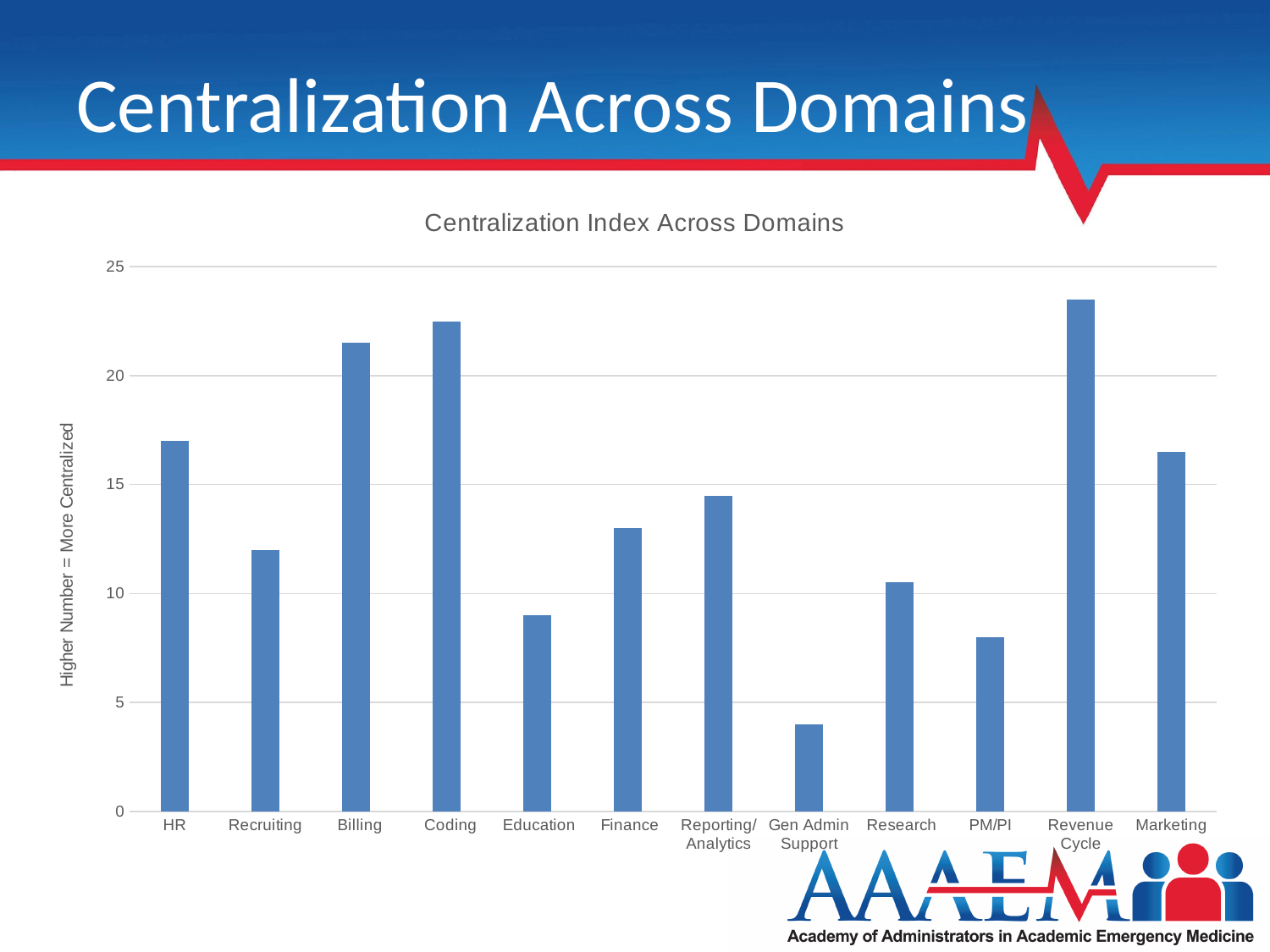
Is the value for Marketing greater or less than 15? greater Which has the higher centralization index, Recruiting or Finance? Finance Is the value for Gen Admin Support greater or less than 5? less Is the value for Education greater or less than 10? less What kind of chart is shown on the slide? bar chart What is the title of the chart? Centralization Index Across Domains How many domains are plotted on the x axis? 12 Which domain has the highest centralization index? Revenue Cycle Which domain has the lowest centralization index? Gen Admin Support Which has the higher centralization index, Billing or Coding? Coding